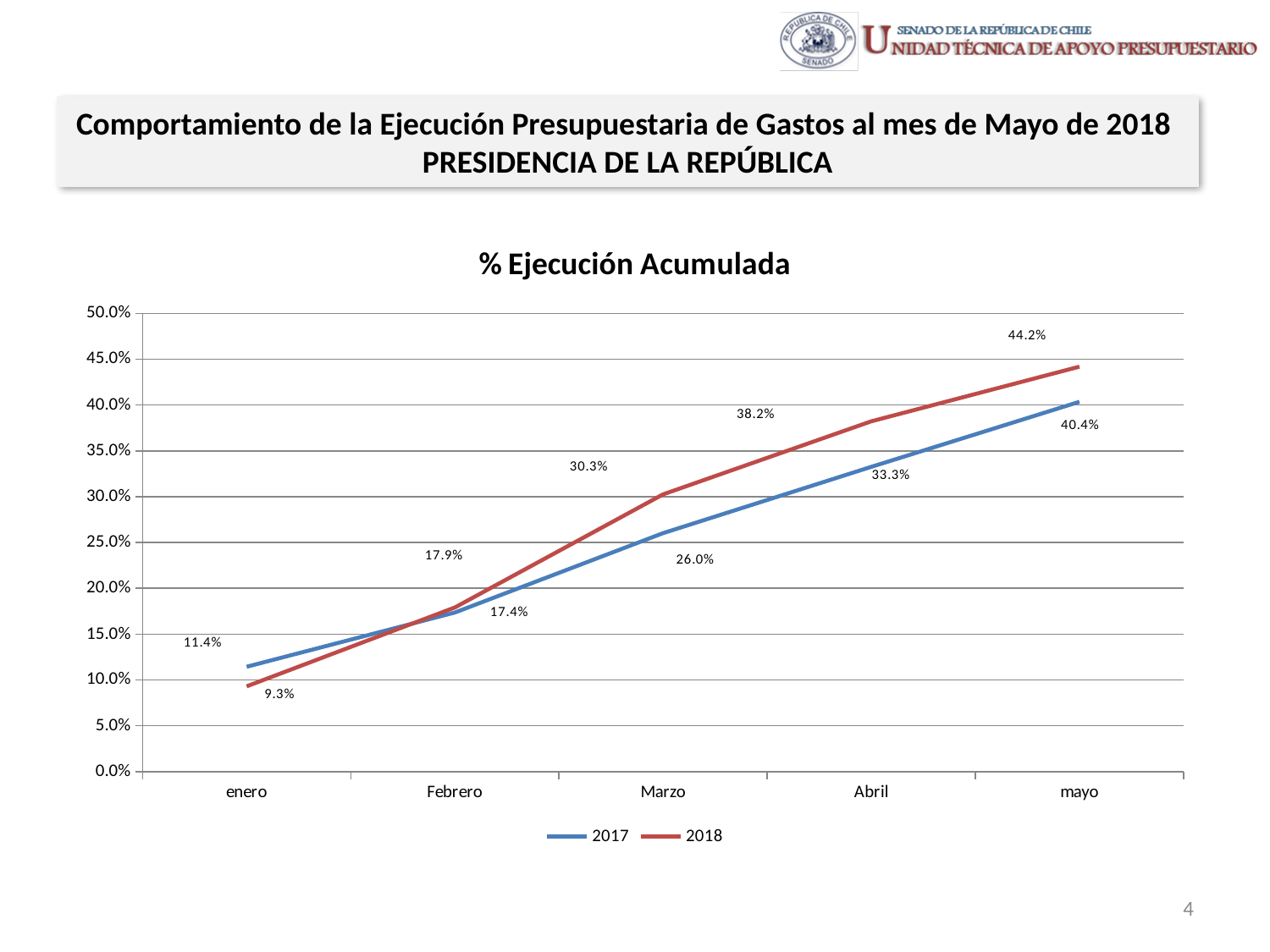
Which series has the higher value in enero, 2017 or 2018? 2017 What is the title of the chart? % Ejecución Acumulada How many months are shown on the x axis? 5 What is the value for 2018 in mayo? 44.2% What is the value for 2018 in Marzo? 30.3% How many series does the legend list? 2 In which month is the 2018 series lowest? enero Do the values for 2017 rise or fall from enero to mayo? rise What is the value for 2017 in enero? 11.4% What is the value for 2017 in Abril? 33.3% What type of chart is shown on the slide? line chart What is the difference between the 2018 and 2017 values in mayo? 3.8%